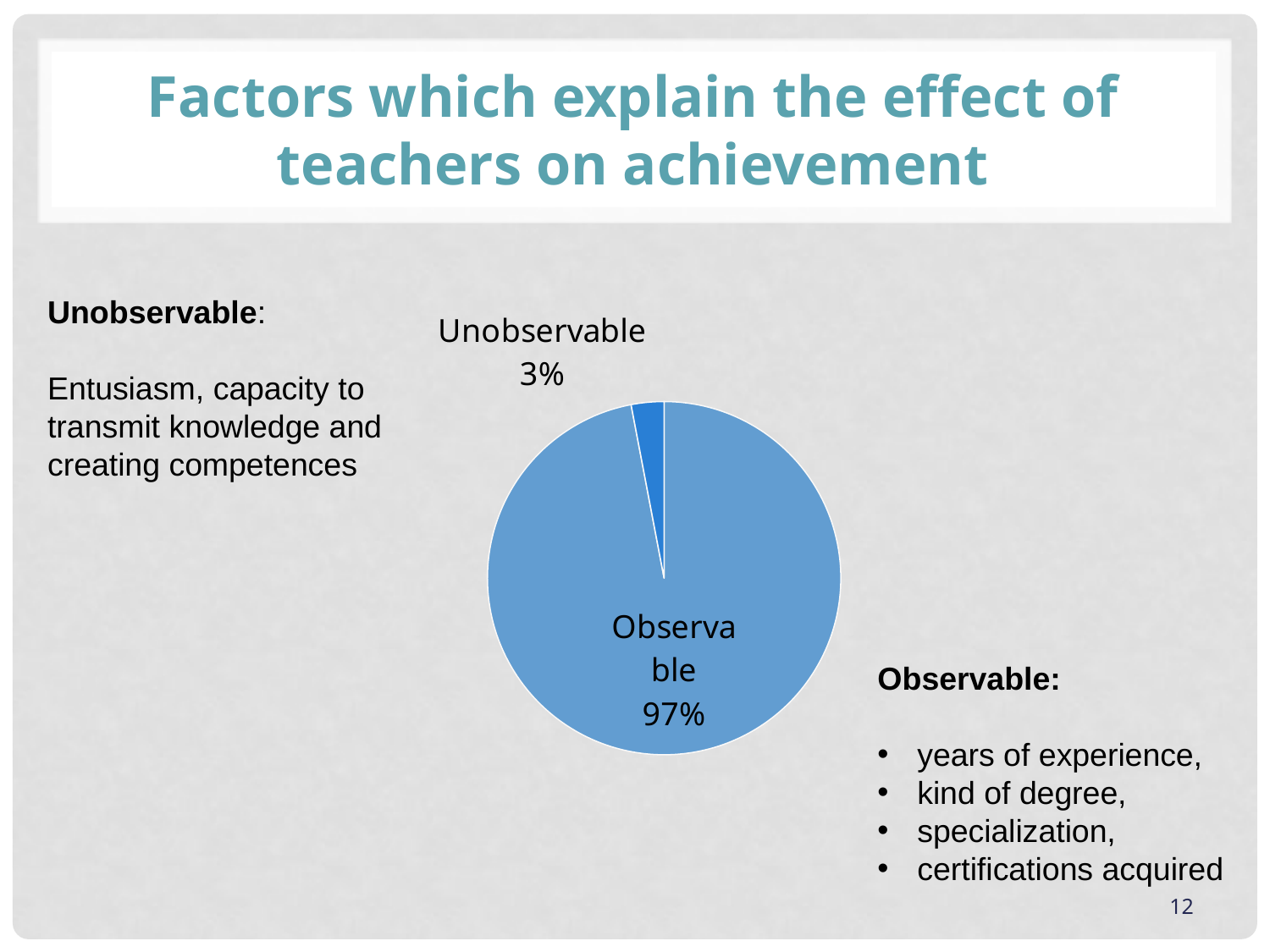
What is the difference in percentage points between the Observable and Unobservable slices? 94 What is the total of the two pie slice percentages? 100% Is the value for Unobservable greater or less than 10%? less Which slice of the pie is the smallest? Unobservable How many slices does the pie chart have? 2 What share of the pie does the Unobservable slice represent? 3% Is the value for Observable greater or less than 90%? greater Which is larger, the Observable slice or the Unobservable slice? Observable What share of the pie does the Observable slice represent? 97% Which slice of the pie is the largest? Observable What kind of chart is shown on the slide? pie chart What is the title of the slide containing the pie chart? Factors which explain the effect of teachers on achievement